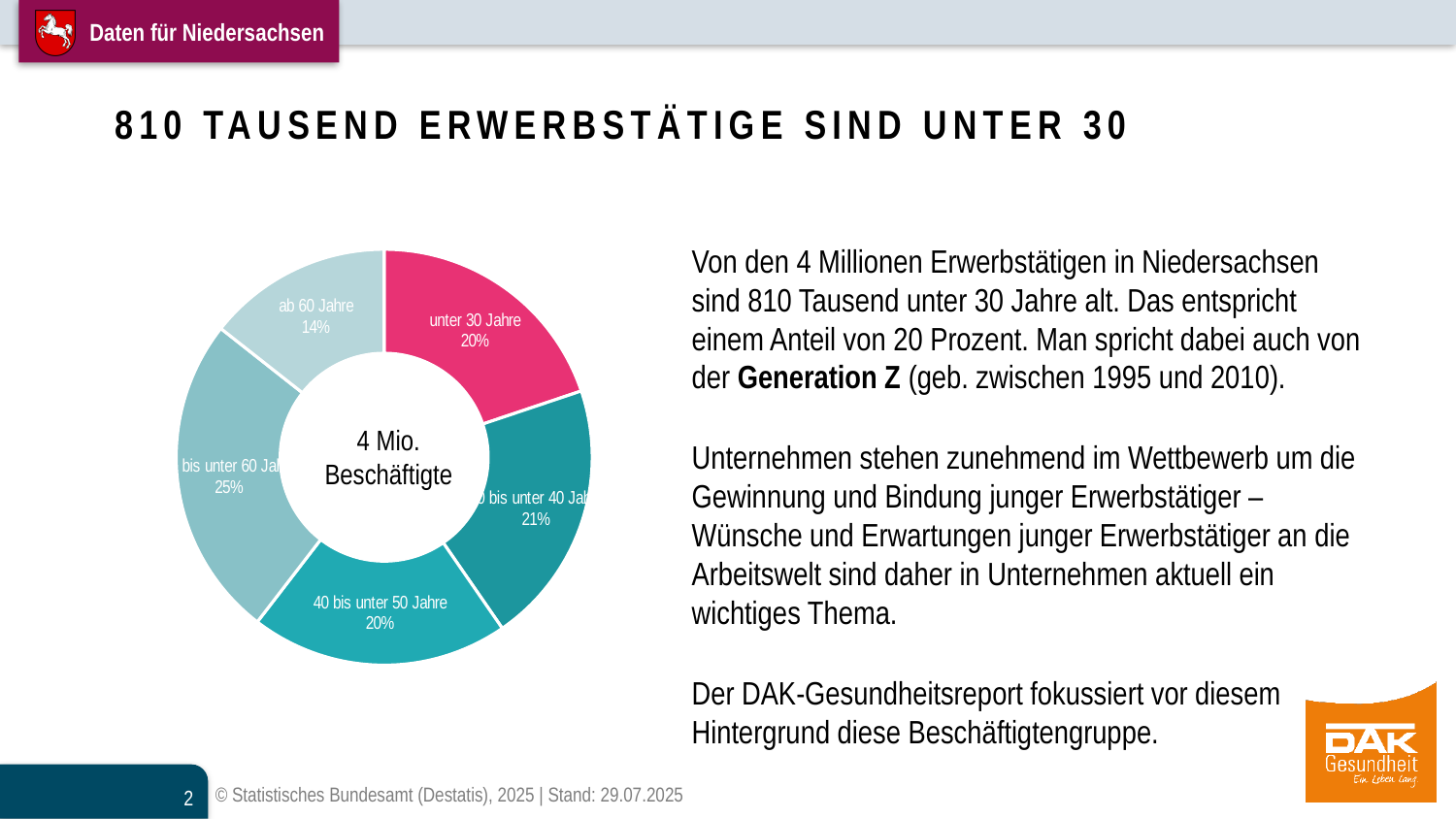
What percentage share does the '40 bis unter 50 Jahre' segment have in the donut chart? 20% What percentage share does the '30 bis unter 40 Jahre' segment have in the donut chart? 21% By how many percentage points does the '50 bis unter 60 Jahre' share exceed the 'ab 60 Jahre' share? 11 percentage points Which age group has the largest share in the donut chart? 50 bis unter 60 Jahre Which age group has the smallest share in the donut chart? ab 60 Jahre How many age-group segments does the donut chart show? 5 What text is shown in the centre of the donut chart? 4 Mio. Beschäftigte What percentage share does the 'unter 30 Jahre' segment have in the donut chart? 20% What type of chart is shown on the slide? Donut (pie) chart What is the combined share of the 'unter 30 Jahre' and '30 bis unter 40 Jahre' segments? 41% What percentage share does the 'ab 60 Jahre' segment have in the donut chart? 14% Which segment has the larger share: '30 bis unter 40 Jahre' or '40 bis unter 50 Jahre'? 30 bis unter 40 Jahre